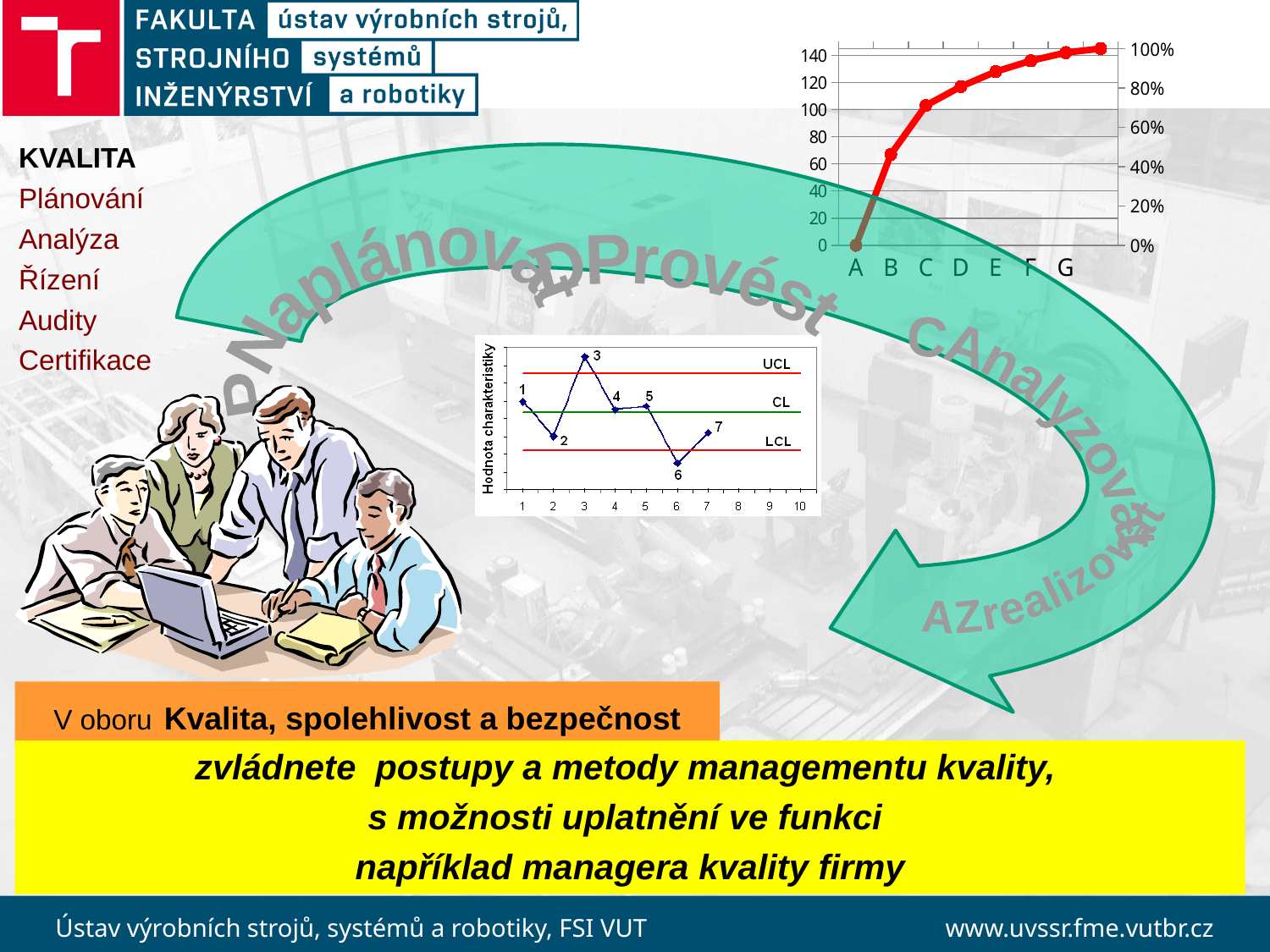
In the top right chart, how many categories are shown on the x axis? 7 In the top right chart, do the values rise or fall from A to G? rise In the control chart in the centre of the slide, which point has the highest value? 3 What kind of chart is the chart in the top right corner of the slide? line chart In the control chart in the centre of the slide, how many data points are plotted? 7 In the control chart in the centre of the slide, what is the label of the y axis? Hodnota charakteristiky In the top right chart, which category has the lowest value? A In the top right chart, which is larger, the value for C or the value for B? C In the control chart in the centre of the slide, which point has the lowest value? 6